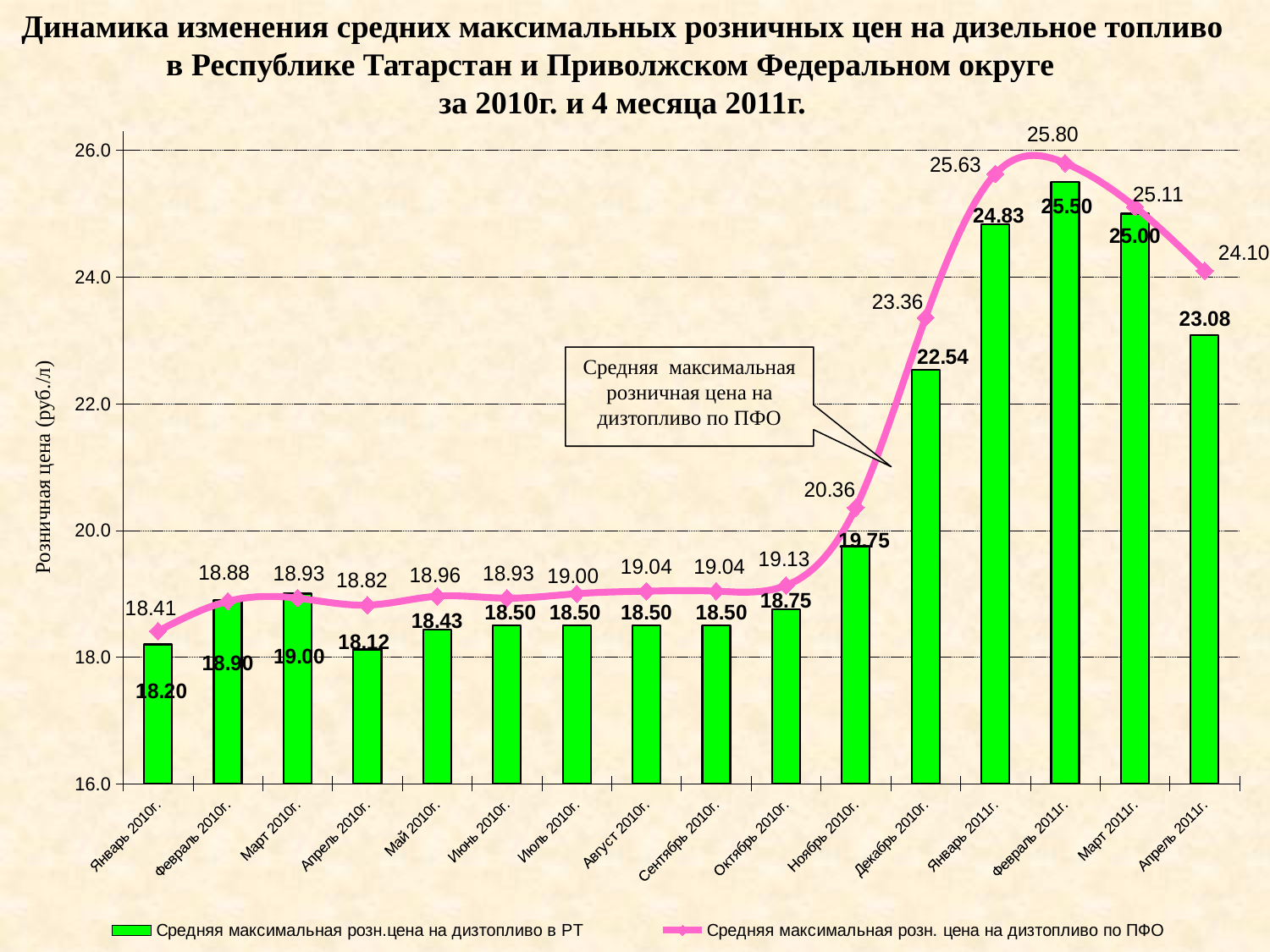
What is the average maximum retail diesel price in ПФО (pink line) for Апрель 2011г.? 24.10 Do the ПФО line values rise or fall from Октябрь 2010г. to Февраль 2011г.? rise Which month has the lowest value for the RT bars? Апрель 2010г. What is the average maximum retail diesel price in RT (green bars) for Февраль 2011г.? 25.50 What is the difference between the ПФО line value and the RT bar value for Декабрь 2010г.? 0.82 Which is larger for Март 2010г.: the RT bar value or the ПФО line value? RT bar value (19.00) How many months are shown on the x axis? 16 What kind of chart is this? Combined bar and line chart How many series does the legend list? 2 What is the value of the green bar for Апрель 2010г.? 18.12 Which month has the highest value on the ПФО line? Февраль 2011г. Is the RT bar value for Январь 2011г. greater or less than 24.0? greater